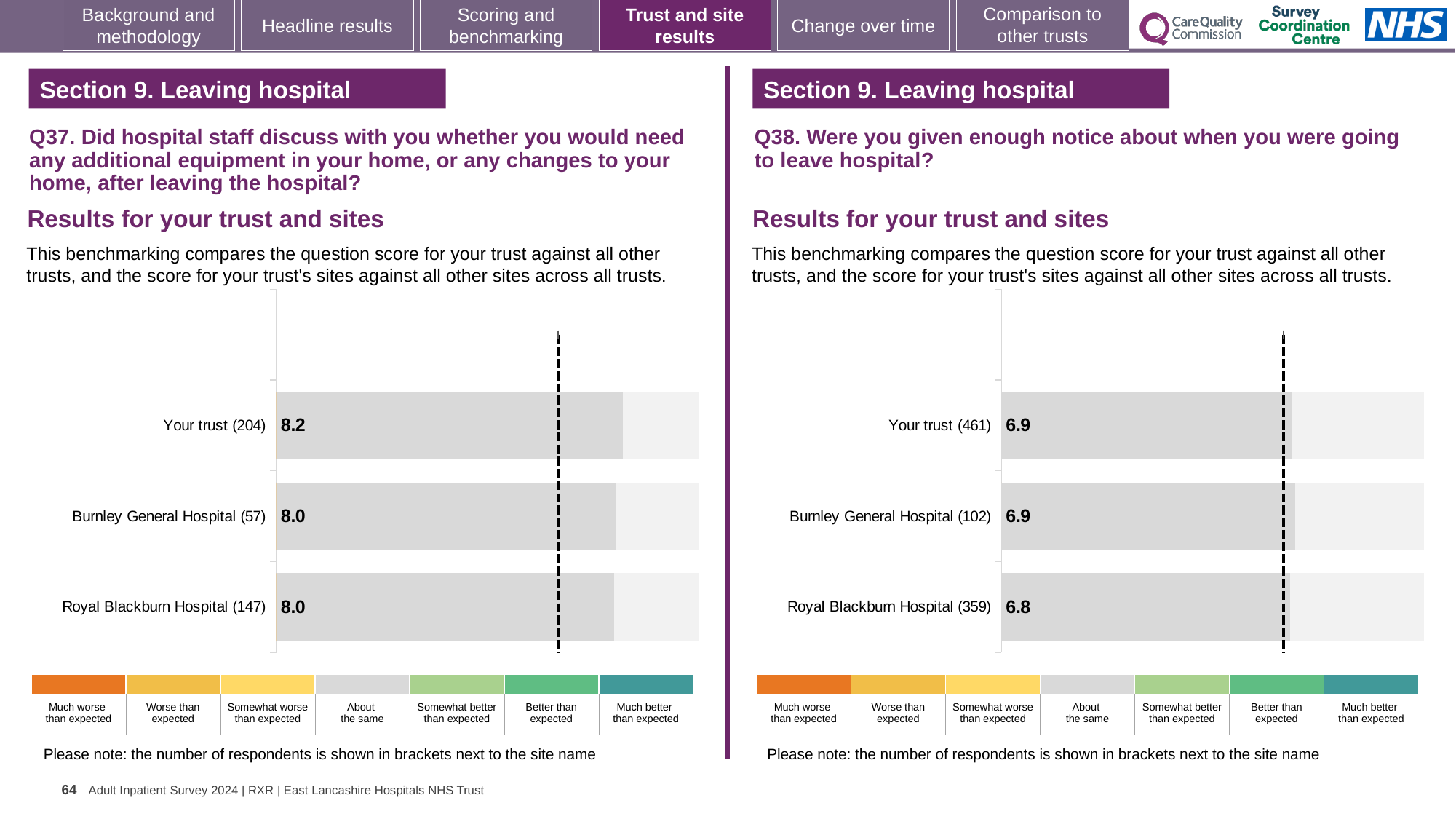
In the Q37 chart on the left, is the score for Your trust larger than the score for Burnley General Hospital? Yes In the Q38 chart on the right, what is the score for Your trust? 6.9 In the Q37 chart on the left, which row has the highest score? Your trust In the Q37 chart on the left, what is the score for Your trust? 8.2 How many rows (trust and sites) are plotted in the Q38 chart on the right? 3 In the Q38 chart on the right, what is the score for Royal Blackburn Hospital? 6.8 In the Q38 chart on the right, what is the difference between the score for Burnley General Hospital and the score for Royal Blackburn Hospital? 0.1 What kind of chart is used for the Q37 results on the left? Bar chart In the Q37 chart on the left, what is the difference between the score for Your trust and the score for Royal Blackburn Hospital? 0.2 In the Q37 chart on the left, how many respondents are shown in brackets for Royal Blackburn Hospital? 147 In the Q37 chart on the left, what is the score for Burnley General Hospital? 8.0 In the Q38 chart on the right, which row has the lowest score? Royal Blackburn Hospital